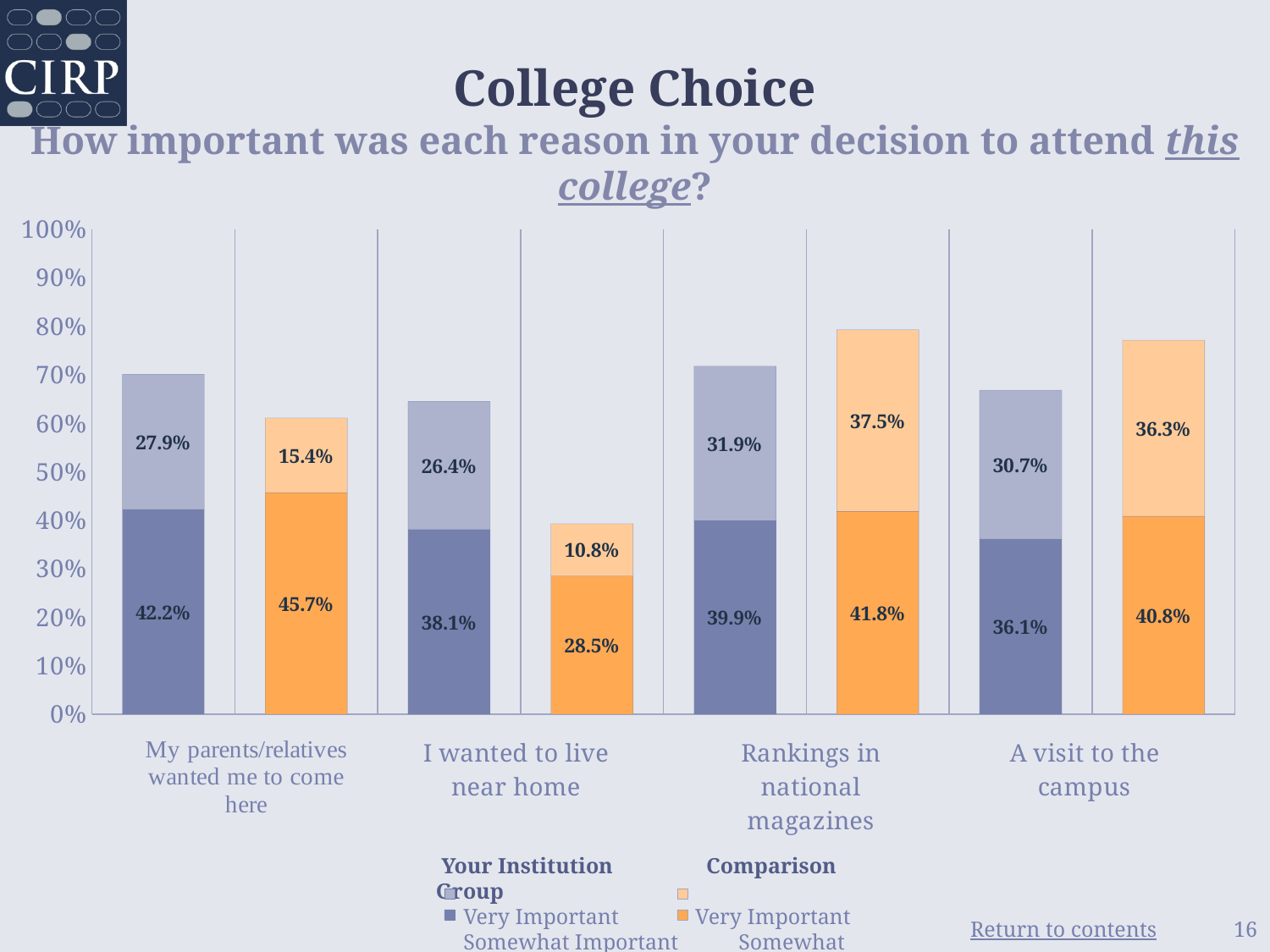
What percentage of Your Institution students rated 'A visit to the campus' as Very Important? 36.1% What kind of chart is shown on the slide? Stacked bar chart Is the total stacked bar for the Comparison Group on 'I wanted to live near home' greater or less than 40%? less What is the difference between the Comparison Group and Your Institution Very Important percentages for 'I wanted to live near home'? 9.6% How many reasons (categories) are shown along the x axis? 4 For 'A visit to the campus', is the Somewhat Important percentage larger for Your Institution or the Comparison Group? Comparison Group What is the combined Very Important and Somewhat Important total for Your Institution on 'My parents/relatives wanted me to come here'? 70.1% What percentage of the Comparison Group rated 'I wanted to live near home' as Somewhat Important? 10.8% What is the combined Very Important and Somewhat Important total for the Comparison Group on 'Rankings in national magazines'? 79.3% Which reason has the highest Very Important percentage for Your Institution? My parents/relatives wanted me to come here What percentage of the Comparison Group rated 'Rankings in national magazines' as Very Important? 41.8% Which reason has the lowest Very Important percentage for the Comparison Group? I wanted to live near home